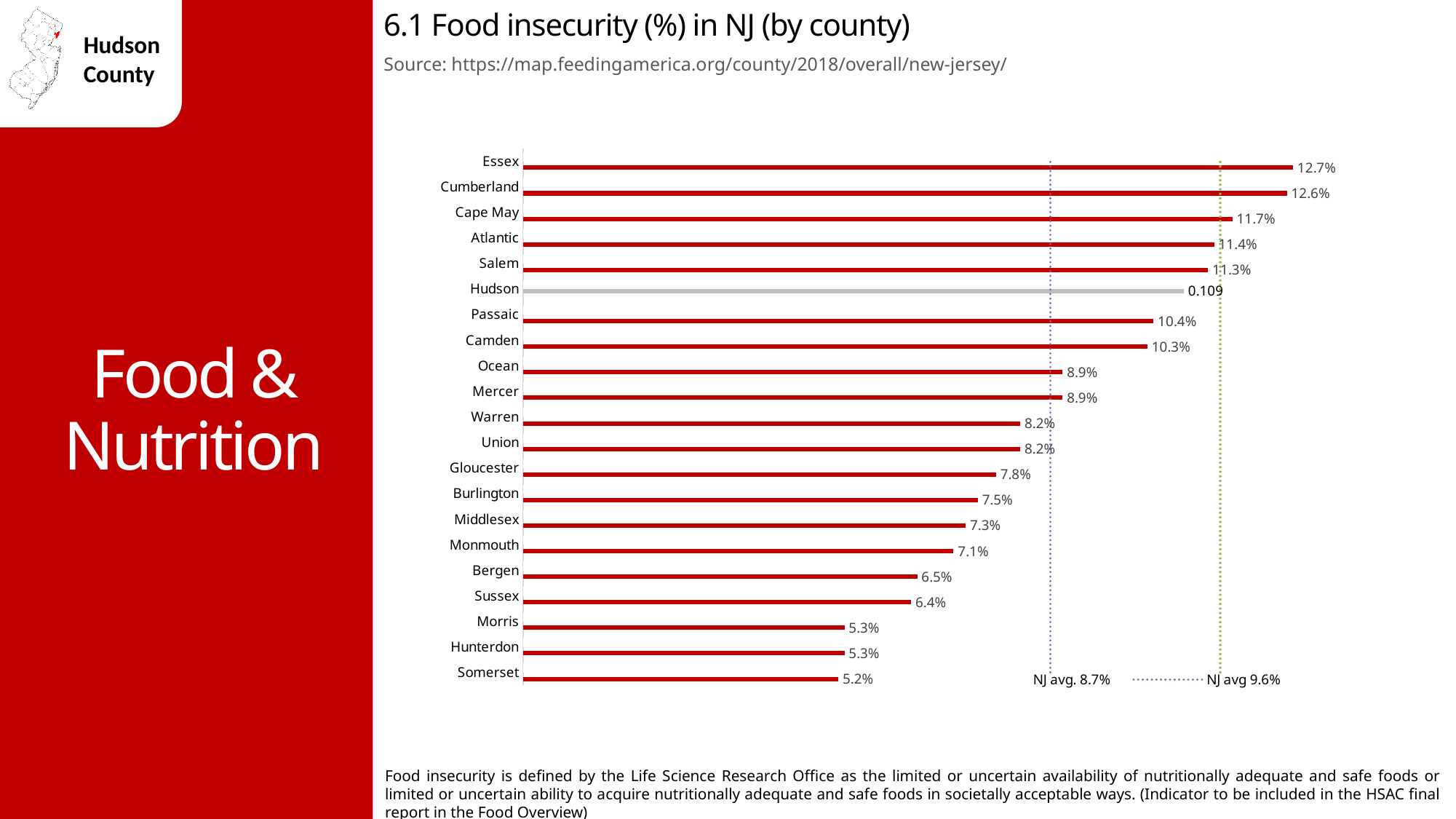
How many counties are shown in the chart? 21 What is the difference between the values for Passaic and Camden? 0.1 percentage points What is the difference between the values for Essex and Somerset? 7.5 percentage points What type of chart is shown on the slide? Bar chart What is the food insecurity value for Somerset? 5.2% What two NJ average values are marked by the dotted reference lines? 8.7% and 9.6% Do the values rise or fall going from the top of the chart to the bottom? Fall Which has a higher food insecurity value, Cape May or Atlantic? Cape May What value is labelled on the Hudson bar? 0.109 What is the food insecurity value for Essex? 12.7% Which county has the lowest food insecurity value? Somerset Which county has the highest food insecurity value? Essex